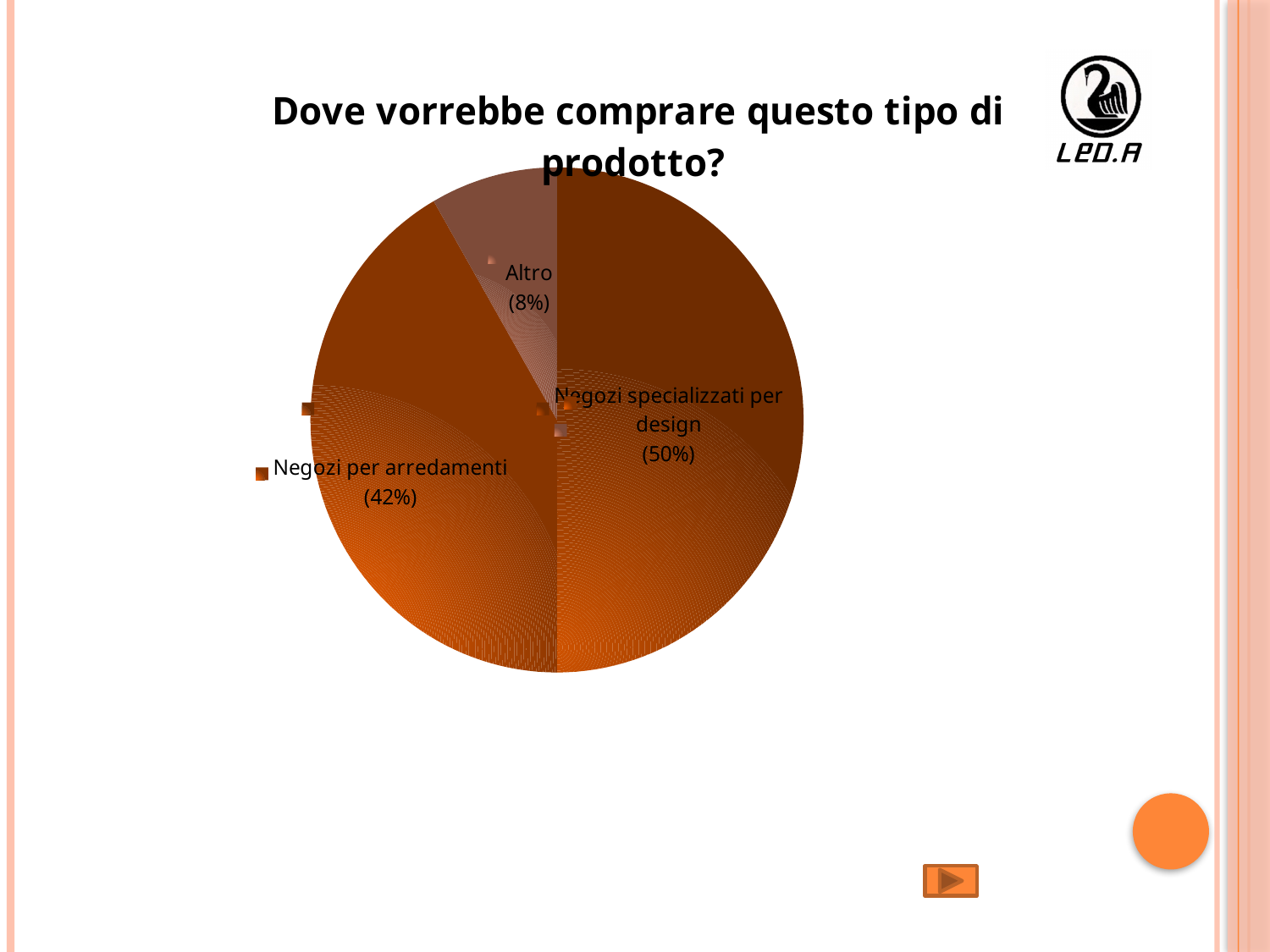
What share of the pie does "Negozi specializzati per design" have? 50% Which is larger, the slice for "Negozi per arredamenti" or the slice for "Altro"? Negozi per arredamenti What share of the pie does "Altro" have? 8% What share of the pie does "Negozi per arredamenti" have? 42% What kind of chart is shown on the slide? pie chart What is the difference in percentage points between "Negozi specializzati per design" and "Negozi per arredamenti"? 8 What is the title of the chart? Dove vorrebbe comprare questo tipo di prodotto? How many slices does the pie chart have? 3 Which category has the largest slice of the pie? Negozi specializzati per design What is the difference in percentage points between "Negozi per arredamenti" and "Altro"? 34 Which category has the smallest slice of the pie? Altro